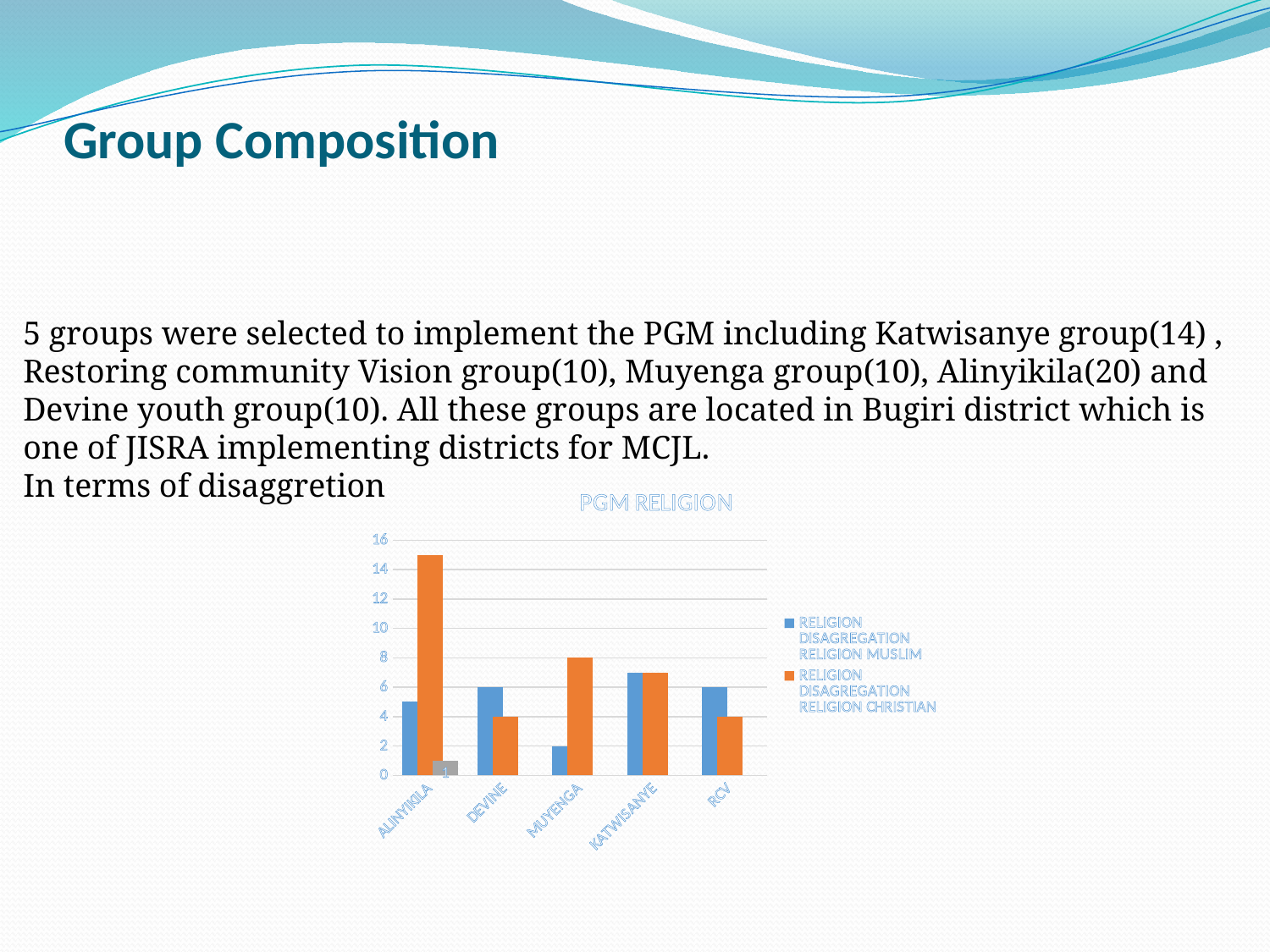
For MUYENGA, which is larger: the Religion Muslim value or the Religion Christian value? Religion Christian Is the Religion Muslim value for KATWISANYE greater or less than 6? greater For DEVINE, which is larger: the Religion Muslim value or the Religion Christian value? Religion Muslim How many groups (categories) are shown on the x axis of the chart? 5 What is the Religion Christian value for MUYENGA? 8 What kind of chart is shown on the slide? bar chart Is the Religion Christian value for ALINYIKILA greater or less than 14? greater How many series does the chart legend list? 2 What is the title of the chart? PGM RELIGION What is the Religion Muslim value for DEVINE? 6 Which group has the lowest Religion Muslim value? MUYENGA Which group has the highest Religion Christian value? ALINYIKILA